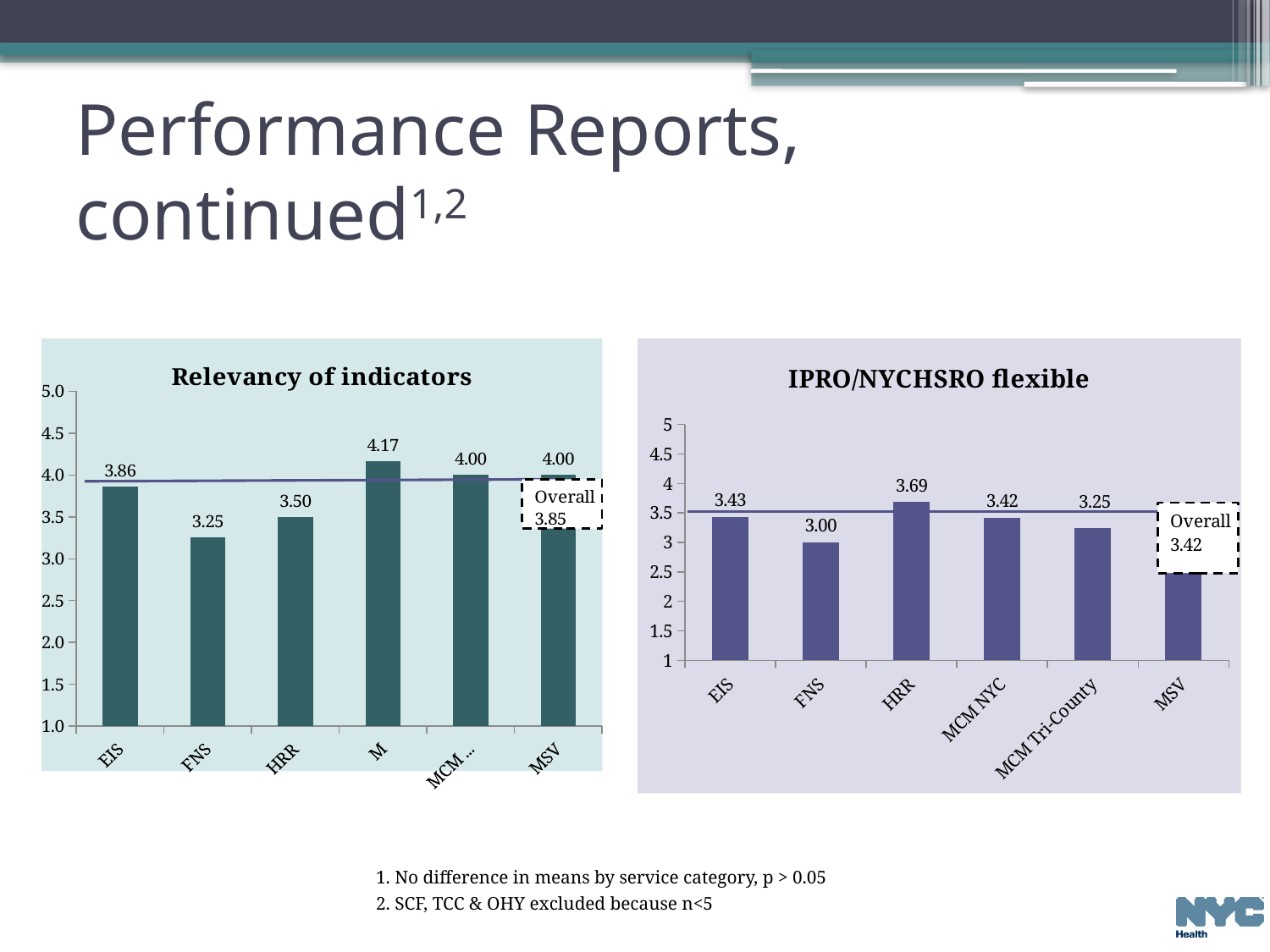
In the IPRO/NYCHSRO flexible chart, which is larger, the value for EIS or the value for FNS? EIS In the IPRO/NYCHSRO flexible chart, what is the value for MCM Tri-County? 3.25 In the Relevancy of indicators chart, what is the value for FNS? 3.25 In the IPRO/NYCHSRO flexible chart, what is the value for HRR? 3.69 In the Relevancy of indicators chart, what is the value for EIS? 3.86 In the Relevancy of indicators chart, what is the Overall value shown? 3.85 What kind of chart is the IPRO/NYCHSRO flexible chart? Bar chart In the Relevancy of indicators chart, what is the difference between the EIS value and the FNS value? 0.61 In the Relevancy of indicators chart, what is the value for HRR? 3.50 In the Relevancy of indicators chart, which category has the lowest value? FNS In the IPRO/NYCHSRO flexible chart, what is the difference between the HRR value and the FNS value? 0.69 In the IPRO/NYCHSRO flexible chart, how many categories are shown on the x axis? 6